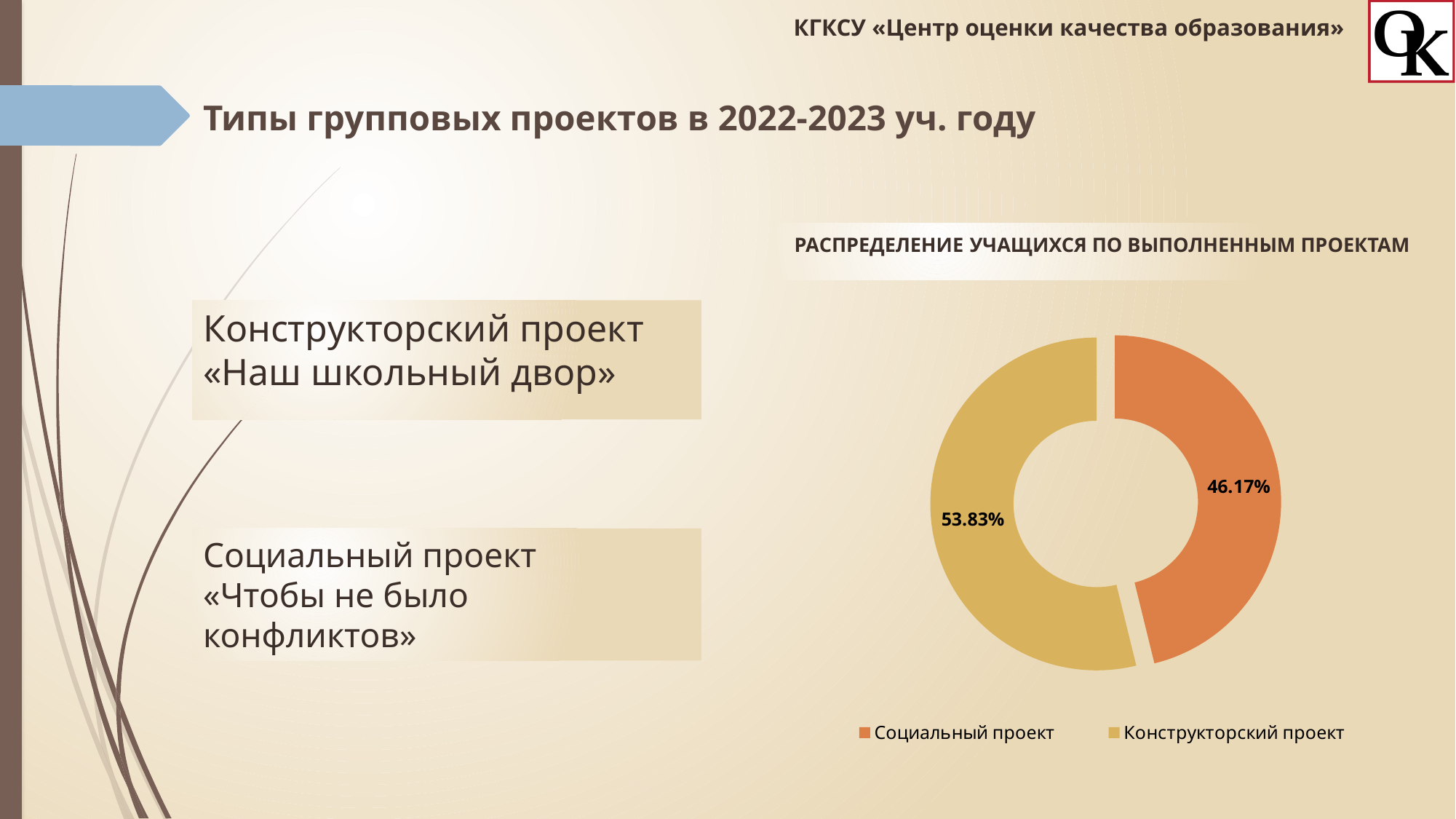
What is the difference in percentage points between the Конструкторский проект and Социальный проект shares? 7.66 Which project type has the larger share of students? Конструкторский проект Which project type has the smaller share of students? Социальный проект What type of chart is shown on the slide? Doughnut (pie) chart How many slices does the chart have? 2 What share of students does the Конструкторский проект slice represent? 53.83% Which colour represents Социальный проект in the chart? Orange What is the title of the chart? РАСПРЕДЕЛЕНИЕ УЧАЩИХСЯ ПО ВЫПОЛНЕННЫМ ПРОЕКТАМ What share of students does the Социальный проект slice represent? 46.17% Is the share for Социальный проект larger or smaller than the share for Конструкторский проект? Smaller How many entries does the legend list? 2 Is the share for Социальный проект greater or less than 50%? less